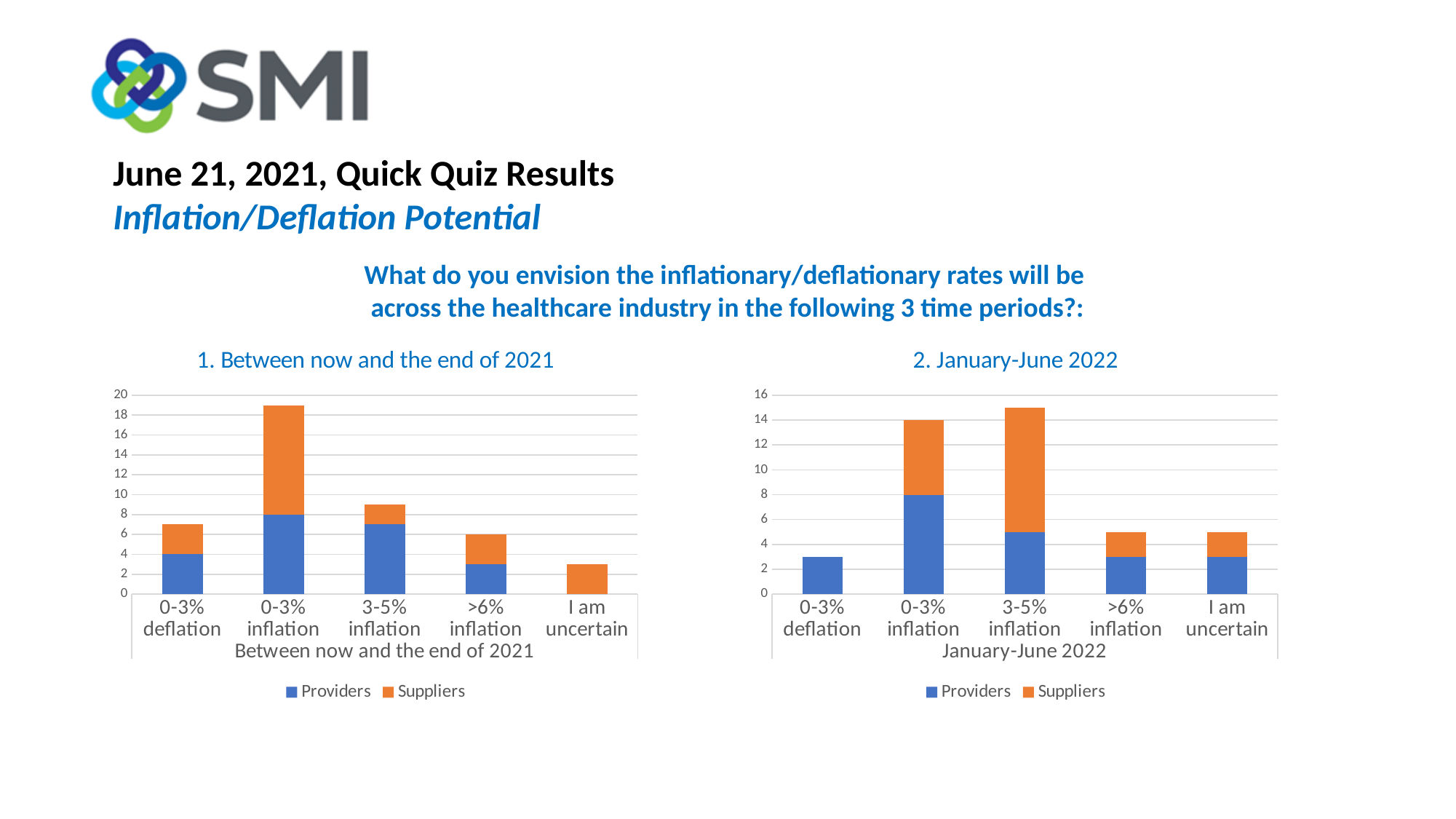
In the chart titled "2. January-June 2022", which is larger: the Providers value for 0-3% inflation or the Providers value for 3-5% inflation? 0-3% inflation How many series does the legend of the chart titled "1. Between now and the end of 2021" list? 2 In the chart titled "2. January-June 2022", which category has the shortest stacked bar? 0-3% deflation In the chart titled "2. January-June 2022", is the total for 3-5% inflation greater or less than 12? greater How many categories are shown on the x axis of the chart titled "2. January-June 2022"? 5 In the chart titled "1. Between now and the end of 2021", what is the Providers value for 0-3% deflation? 4 In the chart titled "1. Between now and the end of 2021", what is the Providers value for 0-3% inflation? 8 In the chart titled "1. Between now and the end of 2021", which category has the shortest stacked bar? I am uncertain In the chart titled "2. January-June 2022", what is the total height of the stacked bar for 0-3% inflation? 14 In the chart titled "1. Between now and the end of 2021", which category has the tallest stacked bar? 0-3% inflation What kind of chart is the chart titled "2. January-June 2022"? Stacked bar chart In the chart titled "1. Between now and the end of 2021", is the total for 0-3% inflation greater or less than 16? greater